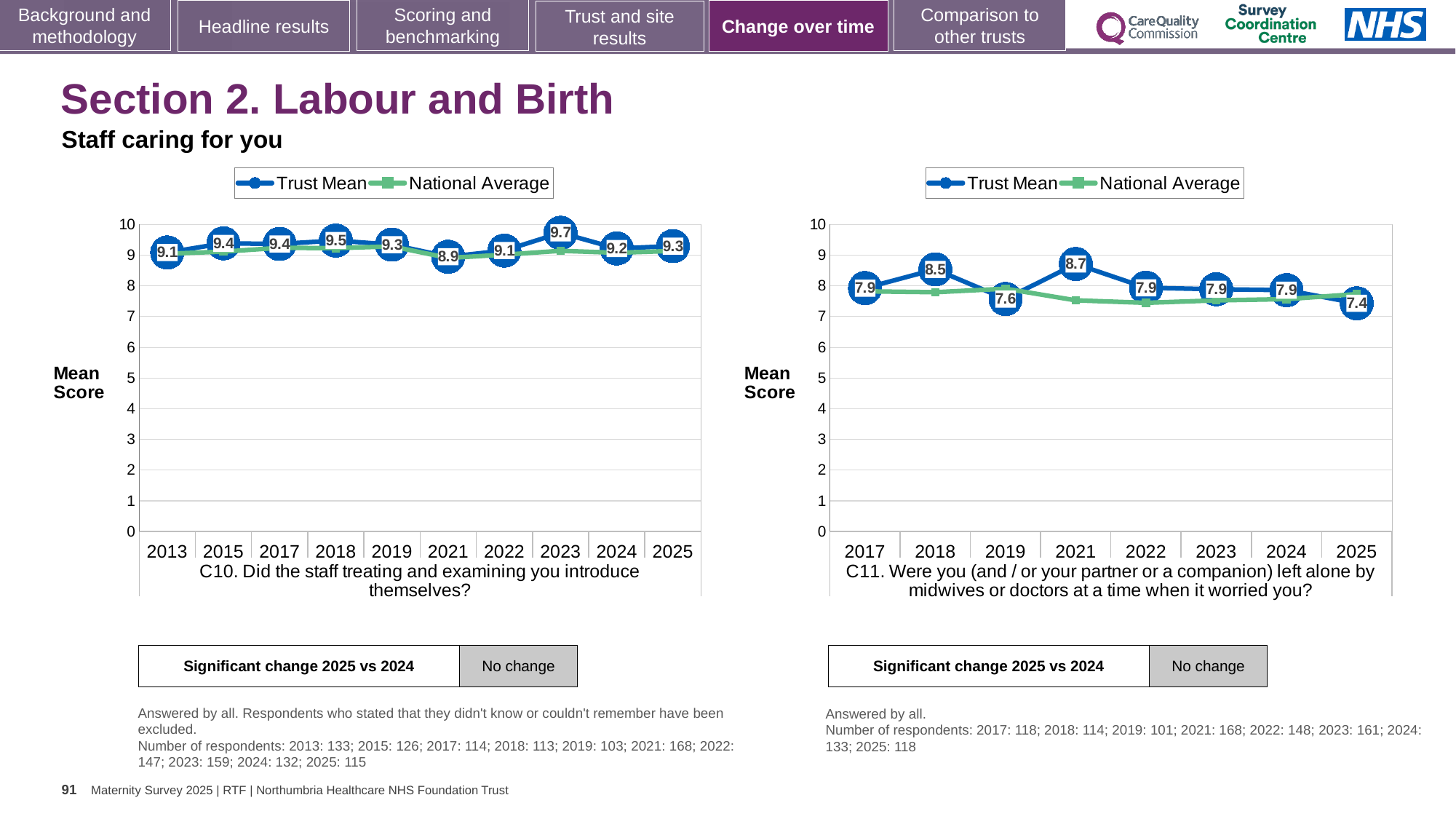
In the C11 chart (right), what is the Trust Mean for 2025? 7.4 What kind of chart is the C10 chart on the left? line chart In the C10 chart (left), what is the Trust Mean for 2023? 9.7 In the C11 chart (right), how many series does the legend list? 2 In the C10 chart (left), what is the Trust Mean for 2021? 8.9 In the C11 chart (right), which year has the highest Trust Mean? 2021 In the C11 chart (right), is the Trust Mean for 2018 larger or smaller than the Trust Mean for 2019? larger In the C11 chart (right), which year has the lowest Trust Mean? 2025 In the C10 chart (left), which year has the highest Trust Mean? 2023 In the C10 chart (left), which year has the lowest Trust Mean? 2021 In the C10 chart (left), what is the difference between the Trust Mean for 2023 and 2021? 0.8 In the C10 chart (left), how many years are plotted on the x axis? 10